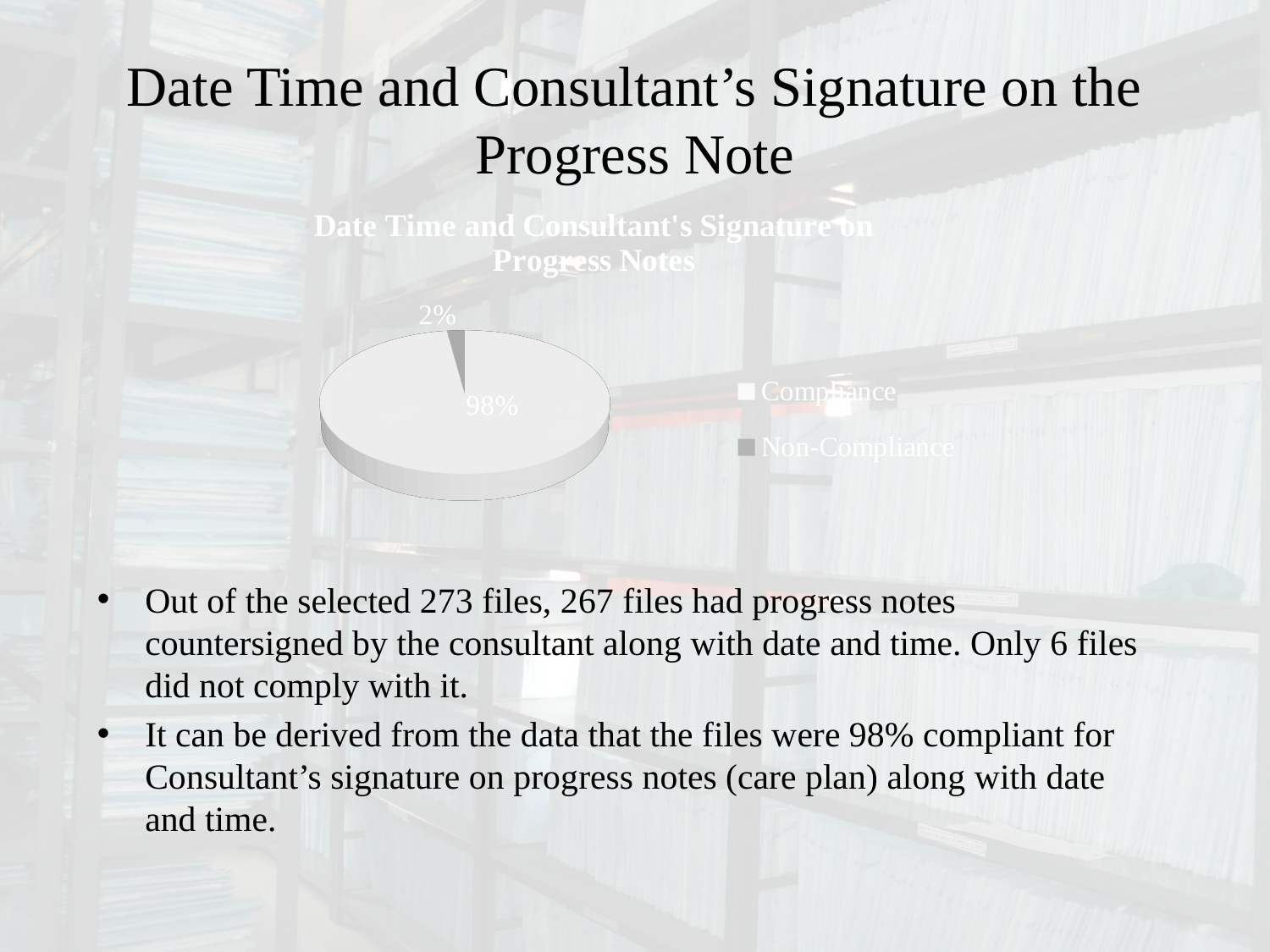
What share of the pie does Compliance represent? 98% How many slices does the pie chart have? 2 What kind of chart is shown on the slide? pie chart Which category has the smallest slice of the pie? Non-Compliance What is the difference in percentage points between the Compliance and Non-Compliance slices? 96 What is the title of the chart? Date Time and Consultant's Signature on Progress Notes Which slice is larger, Compliance or Non-Compliance? Compliance What share of the pie does Non-Compliance represent? 2% What are the two legend entries of the chart? Compliance and Non-Compliance Which category has the largest slice of the pie? Compliance How many entries does the chart legend list? 2